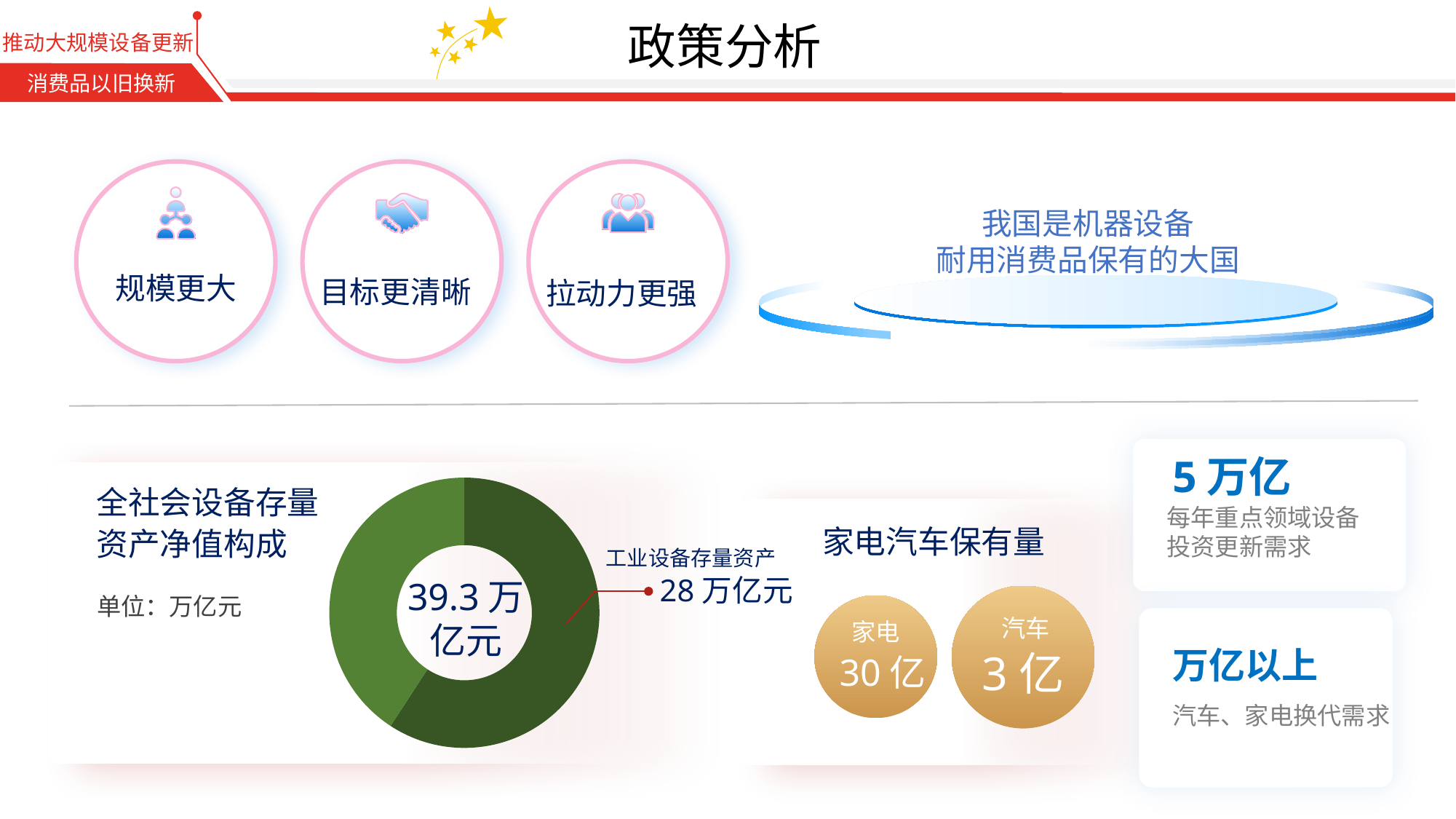
In the 家电汽车保有量 graphic, what is the value shown for 家电? 30 亿 In the 全社会设备存量资产净值构成 chart, what is the value of 工业设备存量资产? 28 万亿元 What unit is stated for the 全社会设备存量资产净值构成 chart? 万亿元 In the 全社会设备存量资产净值构成 chart, is the 工业设备存量资产 slice larger or smaller than the other slice? larger What kind of chart is used for 全社会设备存量资产净值构成? donut chart In the 家电汽车保有量 graphic, which category has the higher value, 家电 or 汽车? 家电 How many slices does the 全社会设备存量资产净值构成 donut chart have? 2 In the 家电汽车保有量 graphic, what is the value shown for 汽车? 3 亿 What total value is shown in the center of the 全社会设备存量资产净值构成 donut chart? 39.3 万亿元 Is the value of 工业设备存量资产 in the donut chart greater or less than 20 万亿元? greater